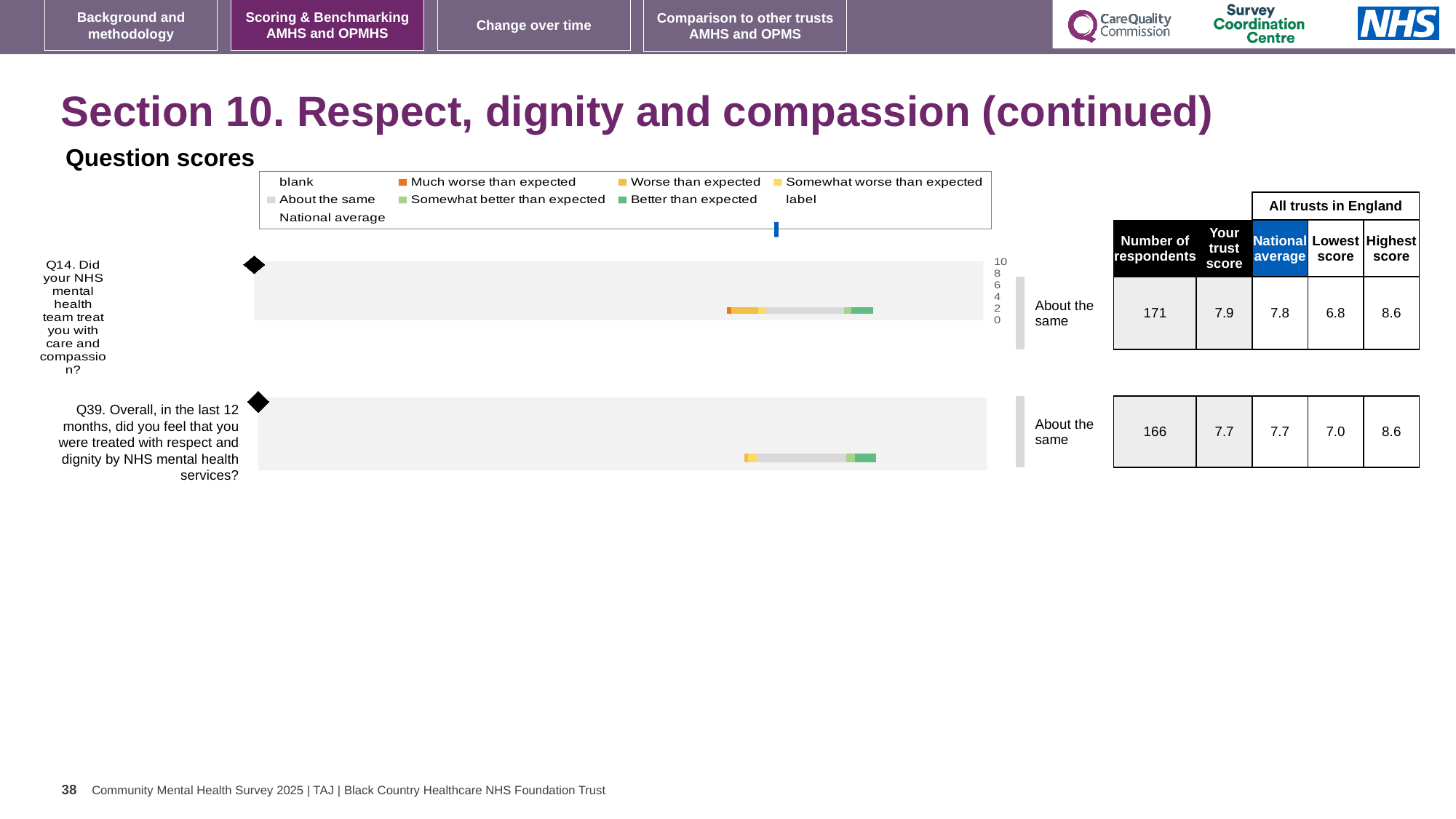
Which question has the higher trust score, Q14 or Q39? Q14 What kind of chart is used to show the question scores? Bar chart What benchmark category label is shown next to the Q14 chart? About the same By how much does the Q14 trust score exceed the national average for Q14? 0.1 Which question has the higher lowest score across all trusts, Q14 or Q39? Q39 What is the national average shown for Q39 (respect and dignity)? 7.7 What is the difference between the highest and lowest scores for Q39? 1.6 What is the lowest score across all trusts in England for Q39? 7.0 How many respondents are shown for Q39? 166 How many questions are plotted on the slide? 2 What is the highest score across all trusts in England for Q14? 8.6 What is the trust score shown for Q14 (care and compassion)? 7.9